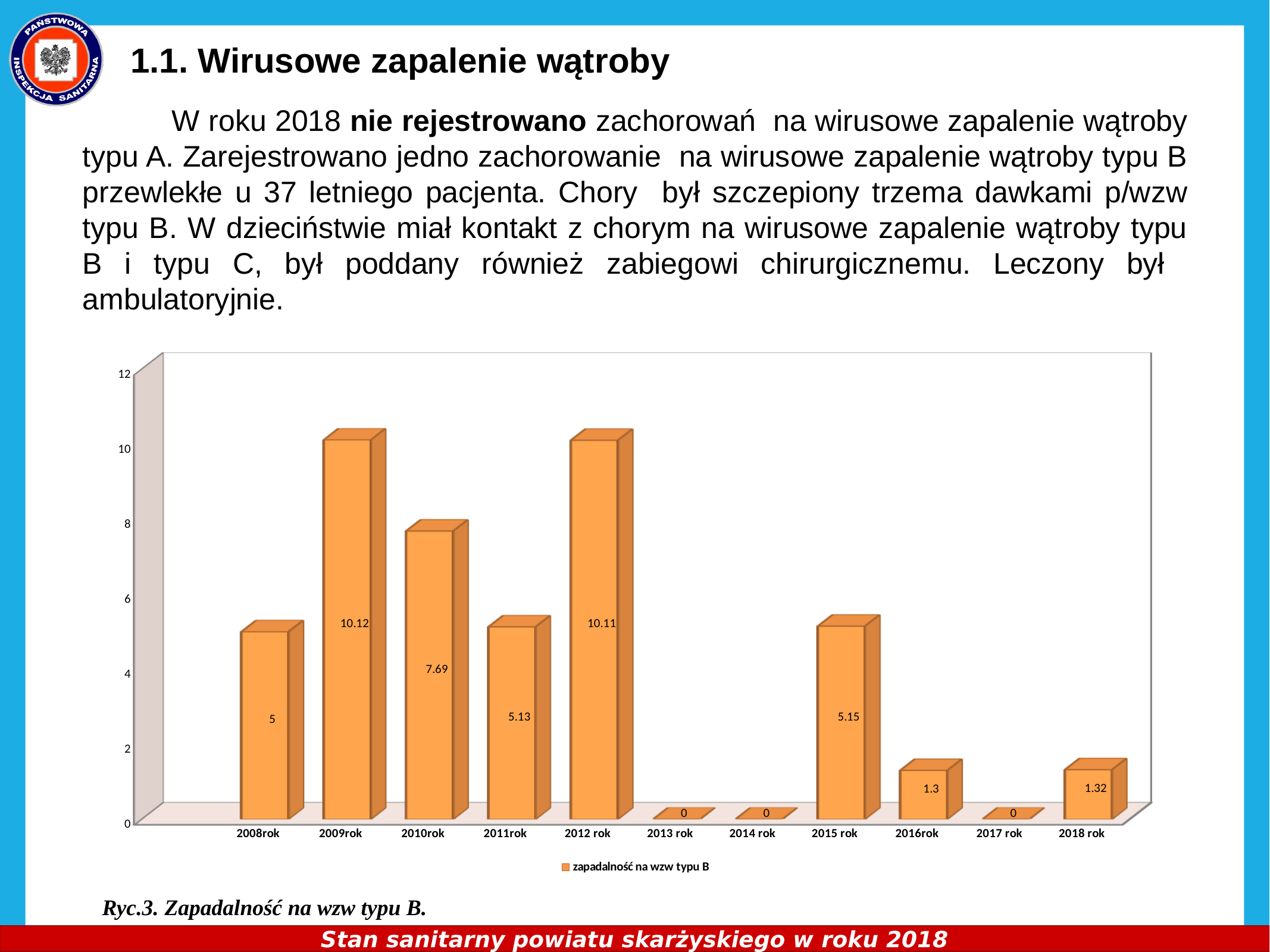
What type of chart is shown on the slide? bar chart How many years are shown on the x axis? 11 Which is larger, the value for 2016rok or the value for 2018 rok? 2018 rok Which year has the highest value? 2009rok How many years have a value of 0? 3 What is the difference between the values for 2009rok and 2010rok? 2.43 How many series does the legend list? 1 What is the value for 2010rok? 7.69 What is the legend entry for the series? zapadalność na wzw typu B What is the value for 2015 rok? 5.15 What is the value for 2018 rok? 1.32 What is the value for 2009rok? 10.12